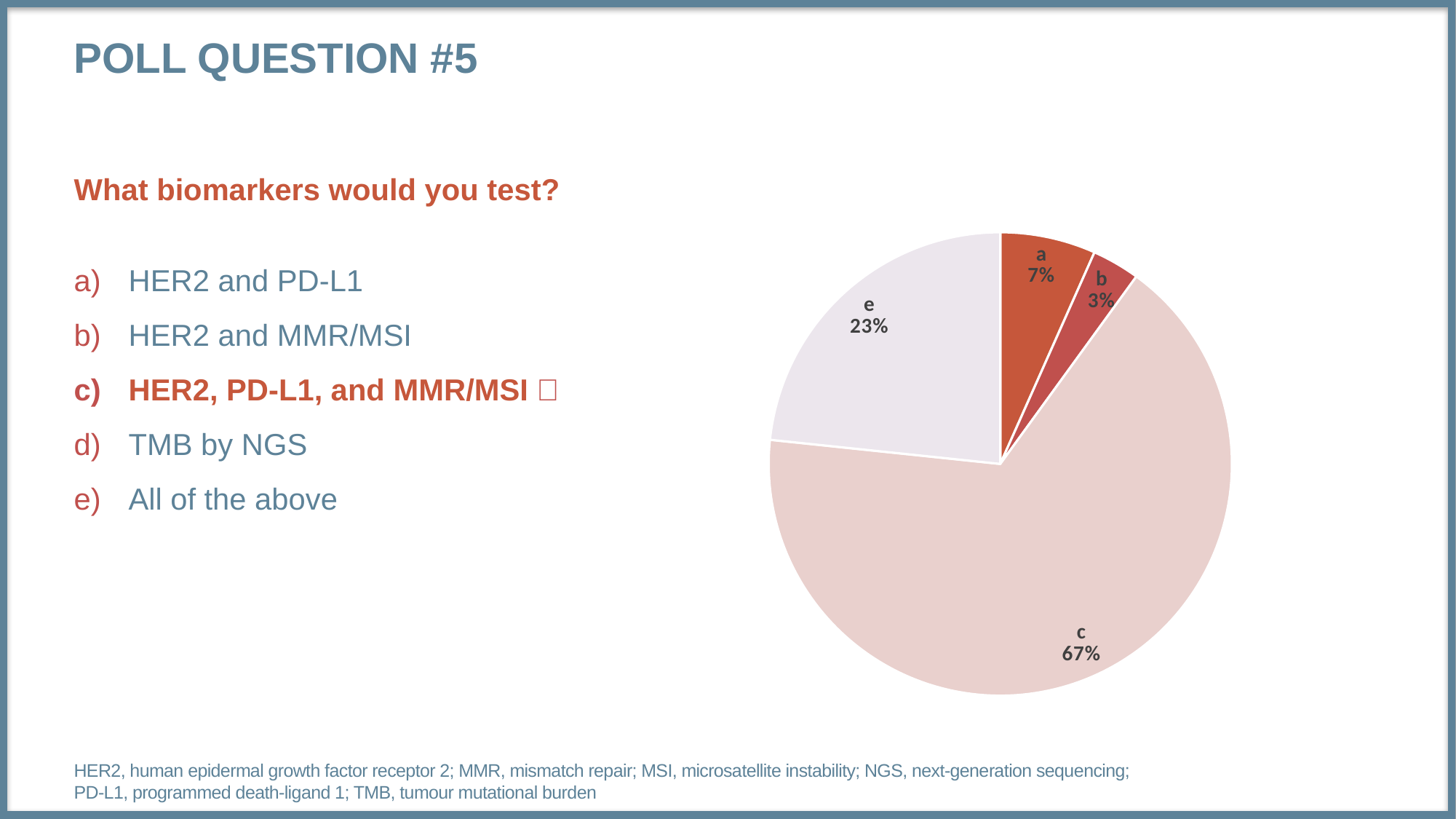
What kind of chart is shown on the slide? pie chart What percentage of respondents chose option c? 67% Which option received the largest share of responses? c What is the difference in percentage points between option c and option e? 44 Which option received the smallest share of responses? b What percentage of respondents chose option a? 7% What percentage of respondents chose option e? 23% How many slices does the pie chart have? 4 Which option is marked as the correct answer in the list on the slide? c What is the combined percentage for options a and b? 10% Which received a larger share of responses, option a or option e? e What percentage of respondents chose option b? 3%